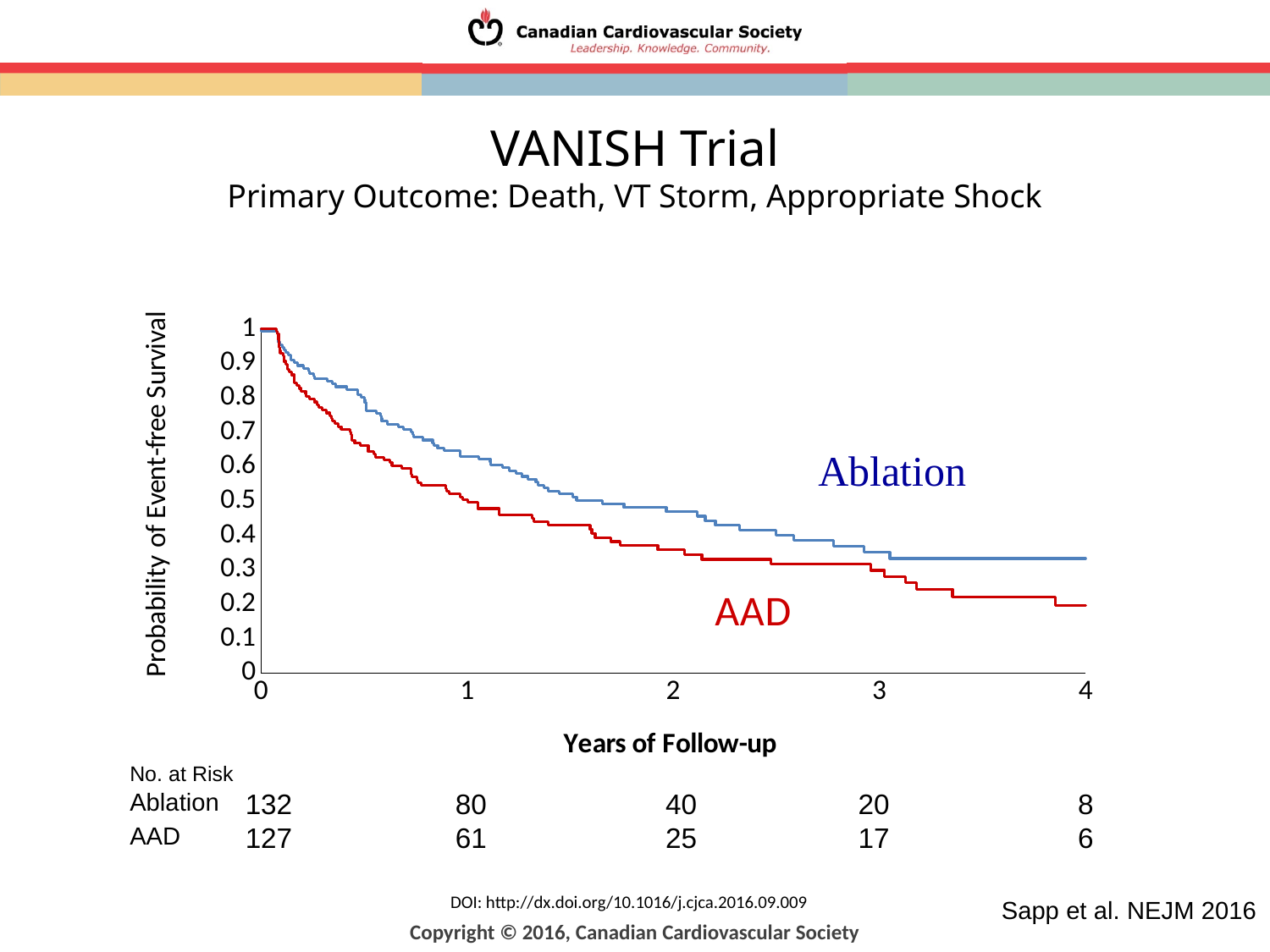
According to the No. at Risk table, how many Ablation patients were at risk at 0 years? 132 Which curve is higher at 2 years of follow-up, Ablation or AAD? Ablation How many series (treatment groups) are plotted on the chart? 2 What colour is the Ablation curve? blue Do the survival curves rise or fall as years of follow-up increase? fall Is the probability of event-free survival for Ablation at 4 years greater or less than 0.3? greater Is the probability of event-free survival for Ablation at 2 years greater or less than 0.5? less What is the label of the x axis? Years of Follow-up According to the No. at Risk table, how many AAD patients were at risk at 2 years? 25 What kind of chart is shown on the slide? line chart What is the difference between the number of Ablation and AAD patients at risk at 1 year? 19